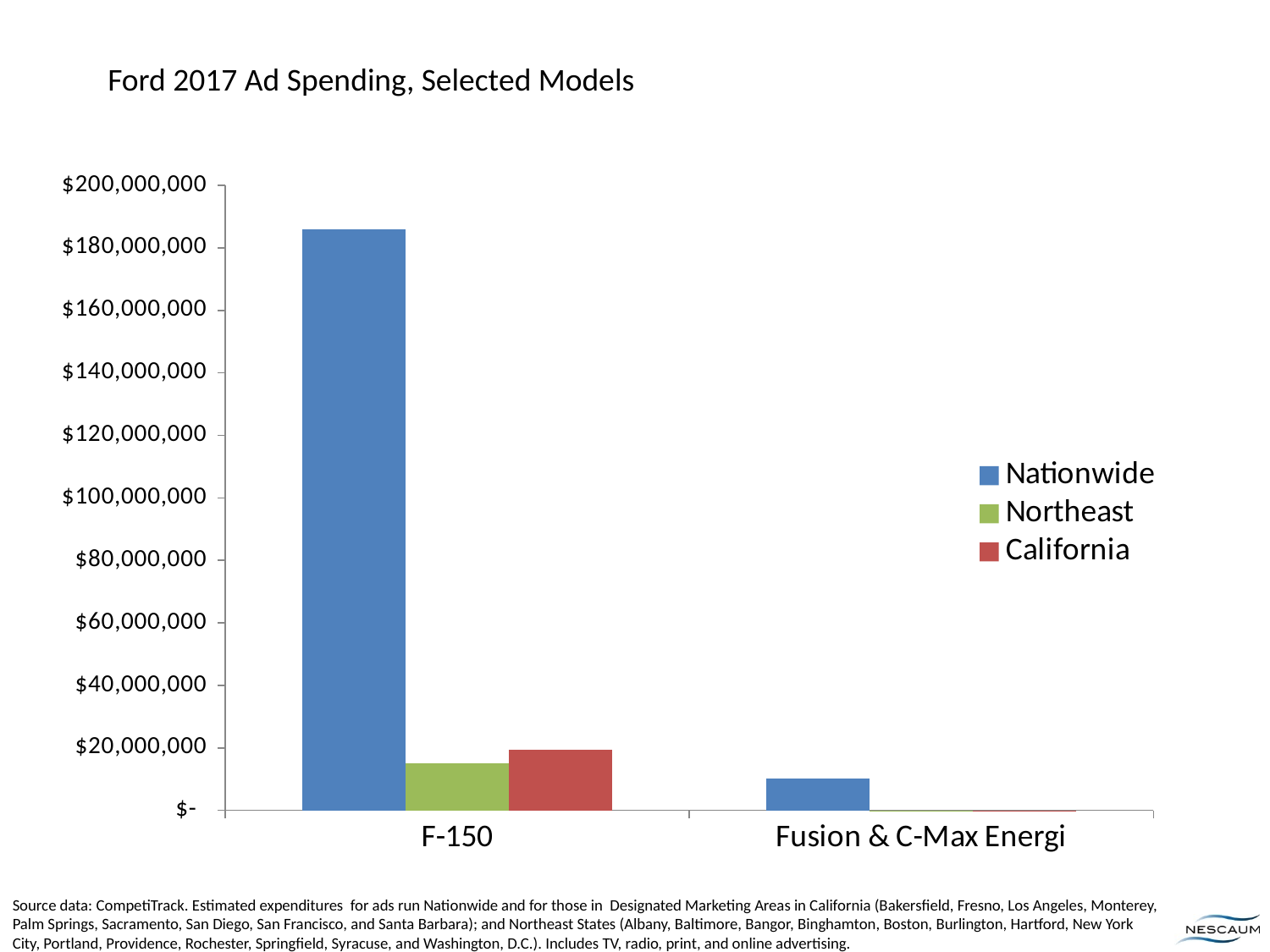
Which model has the larger Nationwide ad spending, F-150 or Fusion & C-Max Energi? F-150 How many model categories are shown on the x axis? 2 Which category and series has the highest ad spending? F-150, Nationwide Is the Northeast value for F-150 greater or less than $20,000,000? less Is the Nationwide value for F-150 greater or less than $160,000,000? greater What is the title of the chart? Ford 2017 Ad Spending, Selected Models What type of chart is shown on the slide? bar chart Which series is shown in blue? Nationwide Is the California value for F-150 greater or less than $40,000,000? less How many series does the legend list? 3 For F-150, which is larger: the Northeast value or the California value? California